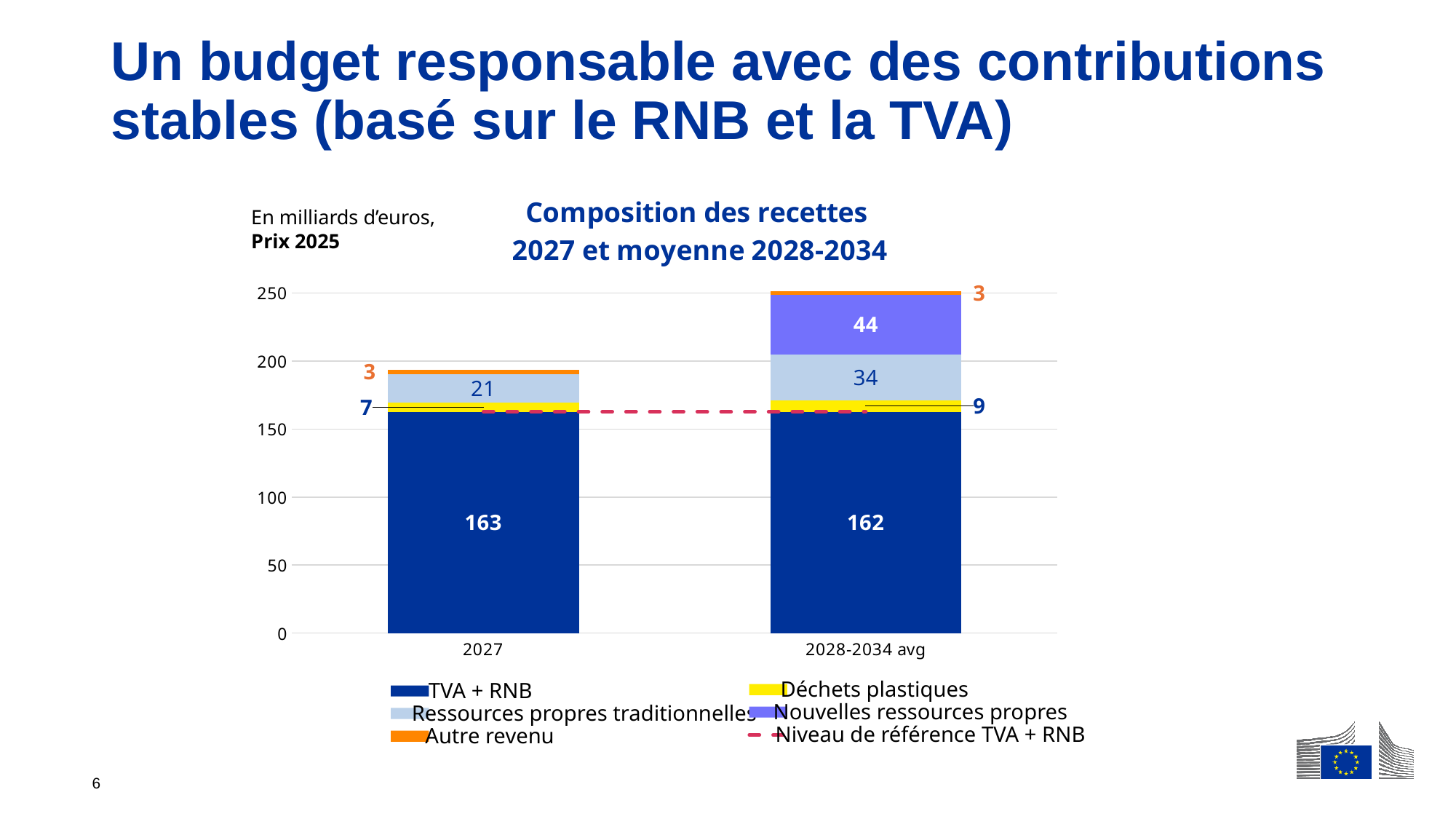
What is the value of Ressources propres traditionnelles for 2028-2034 avg? 34 What is the value of TVA + RNB for 2027? 163 What is the total of the stacked bar for 2028-2034 avg? 252 What is the value of Déchets plastiques for 2027? 7 What kind of chart is shown on the slide? Stacked bar chart How many entries does the legend list? 6 What is the difference between Ressources propres traditionnelles for 2028-2034 avg and for 2027? 13 Which is larger: Déchets plastiques for 2027 or for 2028-2034 avg? 2028-2034 avg What is the total of the stacked bar for 2027? 194 What is the value of Nouvelles ressources propres for 2028-2034 avg? 44 How many categories are shown on the x axis? 2 What is the value of TVA + RNB for 2028-2034 avg? 162